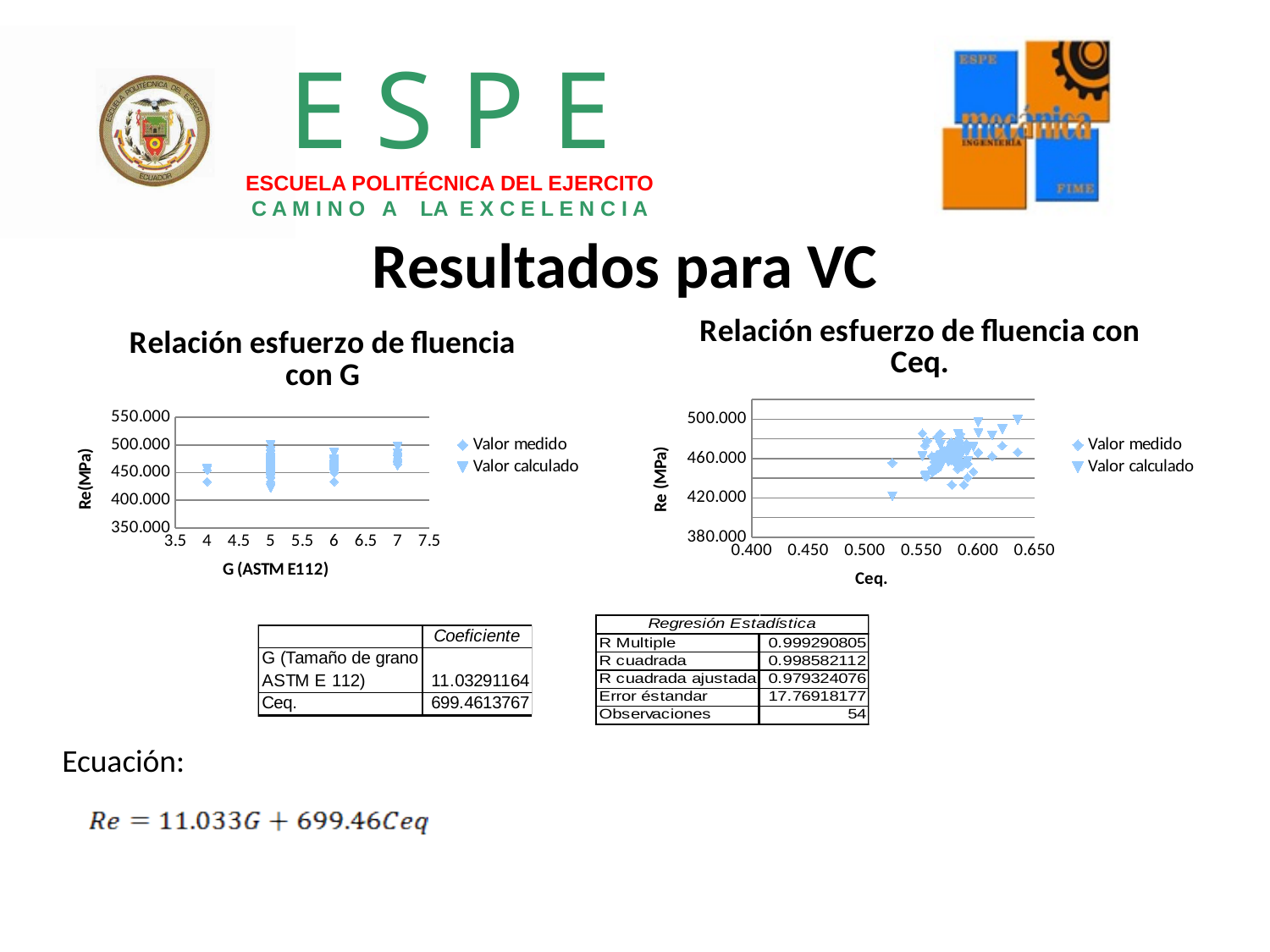
In the chart 'Relación esfuerzo de fluencia con Ceq.', is the highest plotted value greater or less than 480.000 MPa? greater In the chart 'Relación esfuerzo de fluencia con Ceq.', is the lowest plotted value greater or less than 460.000 MPa? less In the chart 'Relación esfuerzo de fluencia con G', are all the plotted values greater or less than 550.000 MPa? less In the chart 'Relación esfuerzo de fluencia con G', what is the label of the x axis? G (ASTM E112) How many series does the legend of the chart 'Relación esfuerzo de fluencia con Ceq.' list? 2 What kind of chart is 'Relación esfuerzo de fluencia con G'? scatter chart In the chart 'Relación esfuerzo de fluencia con Ceq.', what is the label of the y axis? Re (MPa) How many series does the legend of the chart 'Relación esfuerzo de fluencia con G' list? 2 What kind of chart is 'Relación esfuerzo de fluencia con Ceq.'? scatter chart In the chart 'Relación esfuerzo de fluencia con G', how many distinct G values have plotted points? 4